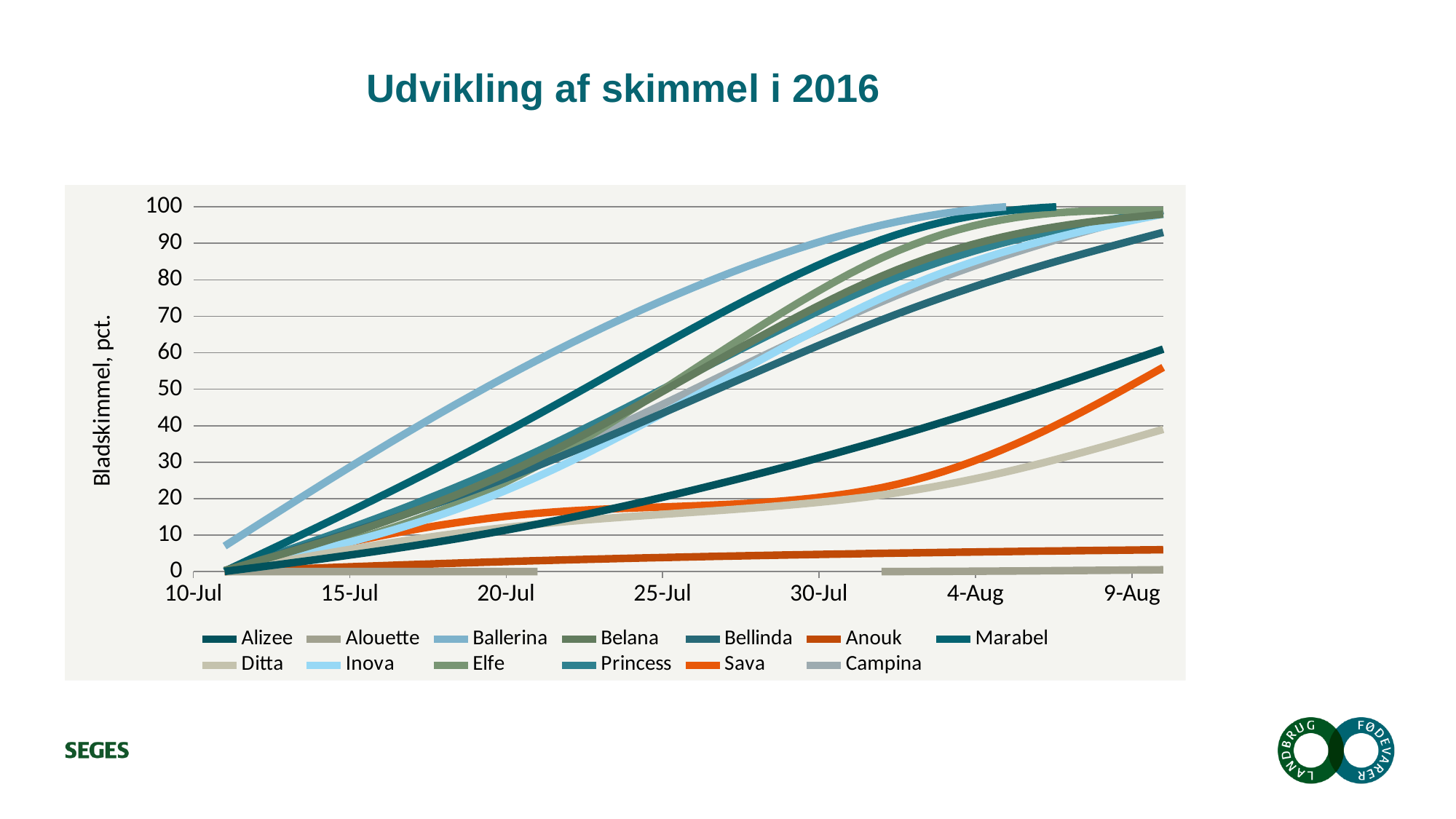
Do the values for Ballerina rise or fall from 10-Jul to 9-Aug? rise Which series has the lowest value at 9-Aug? Alouette Which series has the highest value at 25-Jul? Ballerina Is the value for Alizee at 9-Aug greater or less than 50? greater What is the label on the vertical axis? Bladskimmel, pct. Is the value for Ballerina at 25-Jul greater or less than 70? greater What kind of chart is shown on the slide? line chart How many series does the legend list? 13 How many date labels are shown along the x axis? 7 At 9-Aug, which is larger, the value for Sava or the value for Anouk? Sava Is the value for Alouette at 9-Aug greater or less than 10? less What is the title of the chart? Udvikling af skimmel i 2016